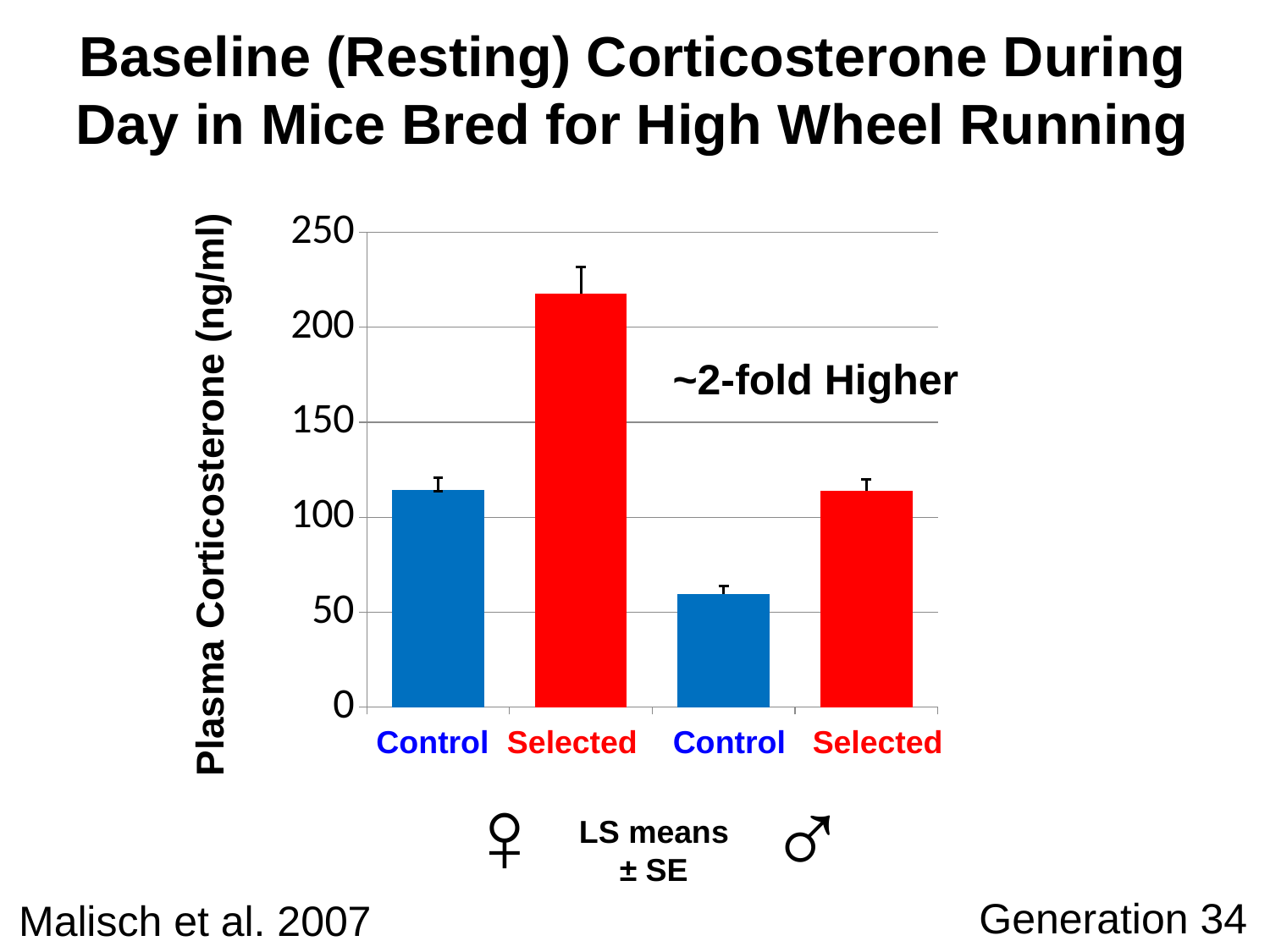
Which bar has the lowest plasma corticosterone value? Control (male) Which is larger, the male Selected bar or the male Control bar? male Selected Is the value for the male Selected bar greater or less than 150? less Is the value for the male Control bar greater or less than 100? less How many bars are plotted in the chart? 4 Which is larger, the female Control bar or the male Control bar? female Control Which bar has the highest plasma corticosterone value? Selected (female) What is the label of the y axis? Plasma Corticosterone (ng/ml) Is the value for the female Control bar greater or less than 100? greater What colour are the Selected bars? red What kind of chart is shown on the slide? bar chart